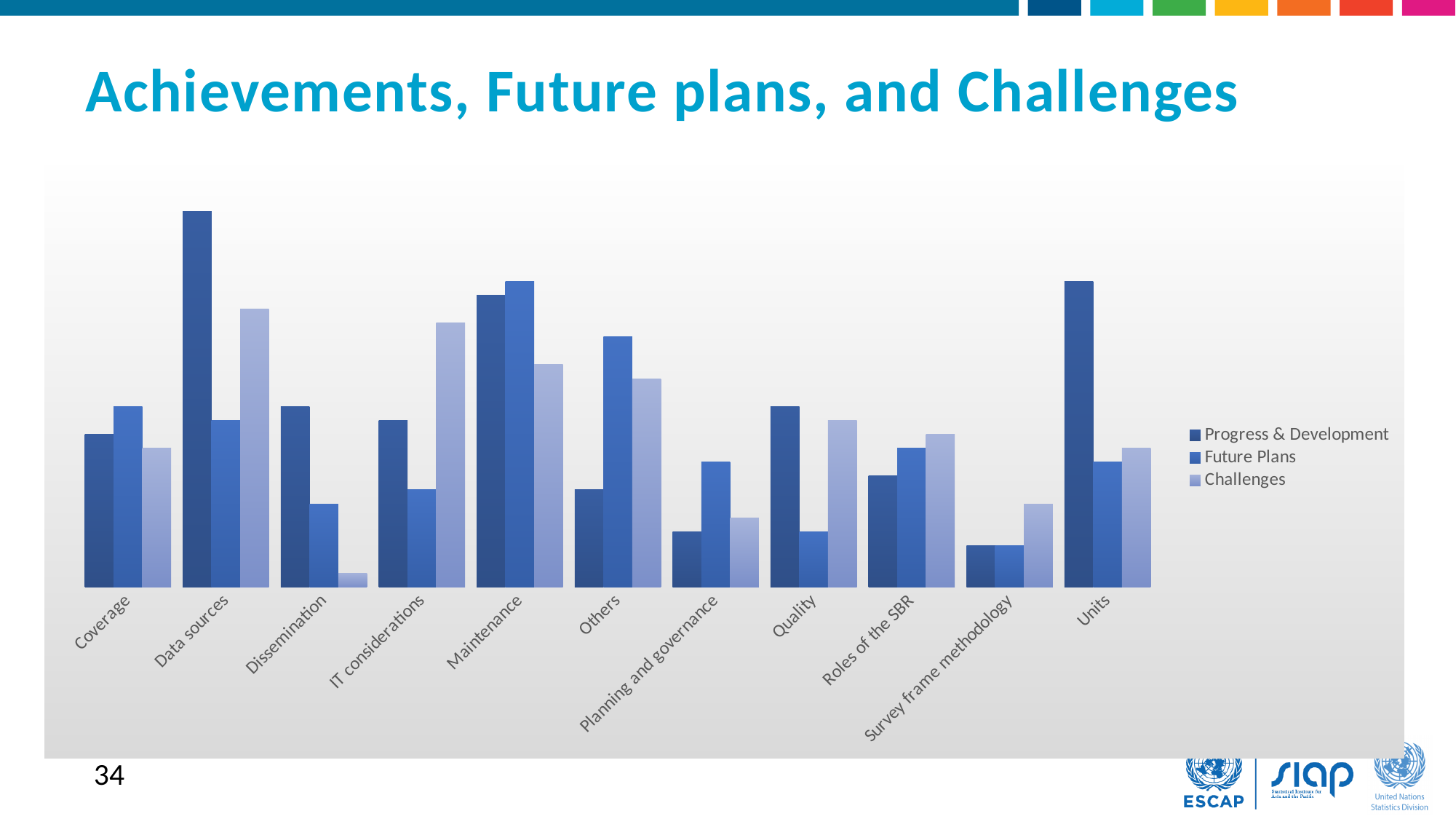
For Units, which is larger: Progress & Development or Future Plans? Progress & Development How many series does the legend list? 3 Which series is shown in the lightest shade of blue in the legend? Challenges What is the title of the slide containing the chart? Achievements, Future plans, and Challenges For Quality, which is larger: Future Plans or Challenges? Challenges Which category has the lowest Challenges value? Dissemination For Others, which is larger: Progress & Development or Future Plans? Future Plans Which category has the highest Future Plans value? Maintenance Which category has the lowest Progress & Development value? Survey frame methodology Which category has the highest Progress & Development value? Data sources How many categories are shown on the x axis? 11 What kind of chart is shown on the slide? Bar chart